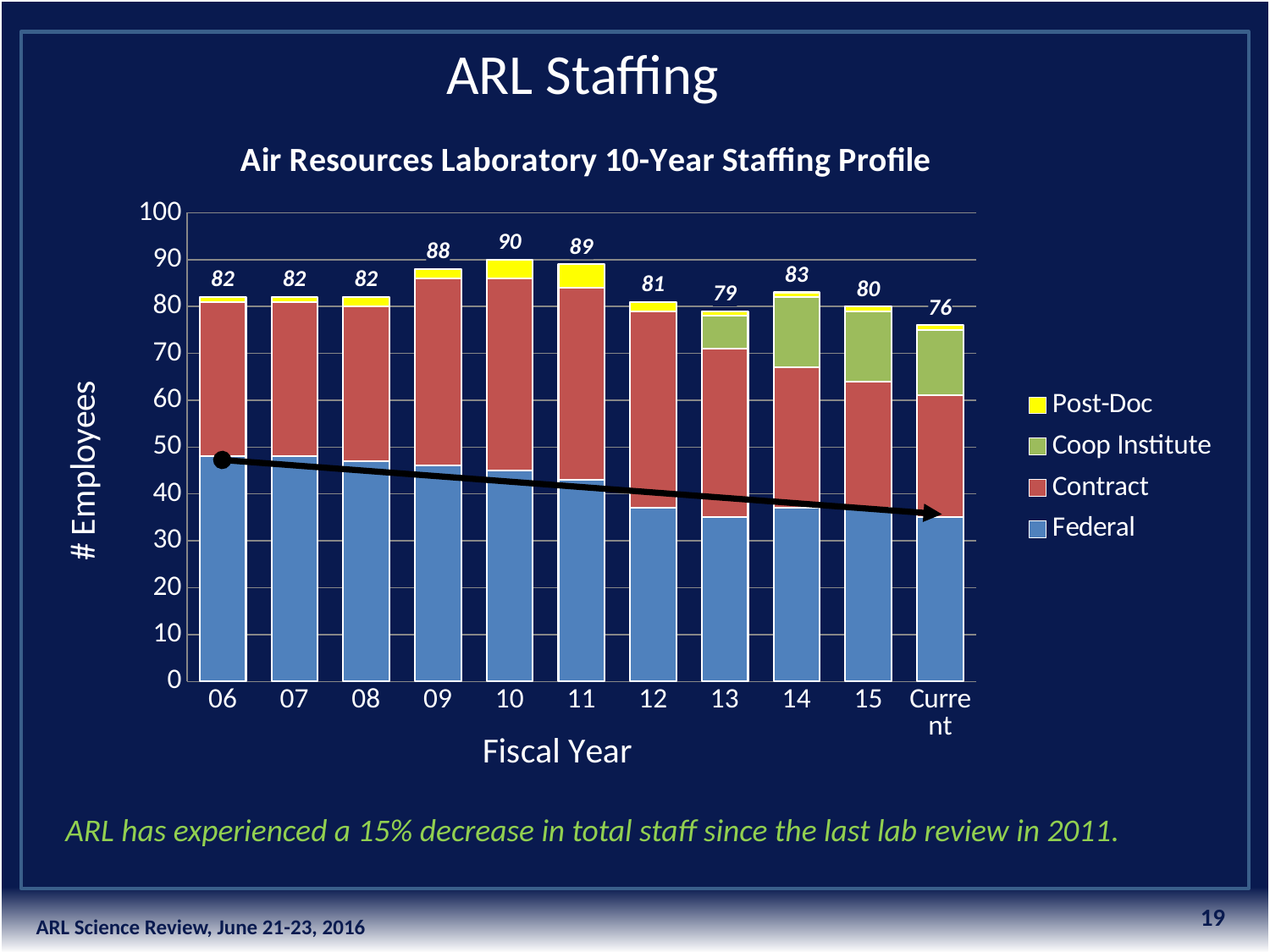
What is the title of the chart? Air Resources Laboratory 10-Year Staffing Profile Is the Federal value for the Current bar greater or less than 40? less How many series does the legend list? 4 What type of chart is shown on the slide? stacked bar chart Which has a larger total number of employees, fiscal year 09 or fiscal year 14? 09 Which fiscal year has the highest total number of employees? 10 How many fiscal year categories are shown on the x axis? 11 What is the total number of employees shown for fiscal year 10? 90 What is the difference between the total employees in fiscal year 11 and the Current total? 13 Which bar has the lowest total number of employees? Current Is the Federal value for fiscal year 06 greater or less than 40? greater What is the total number of employees shown for the Current bar? 76